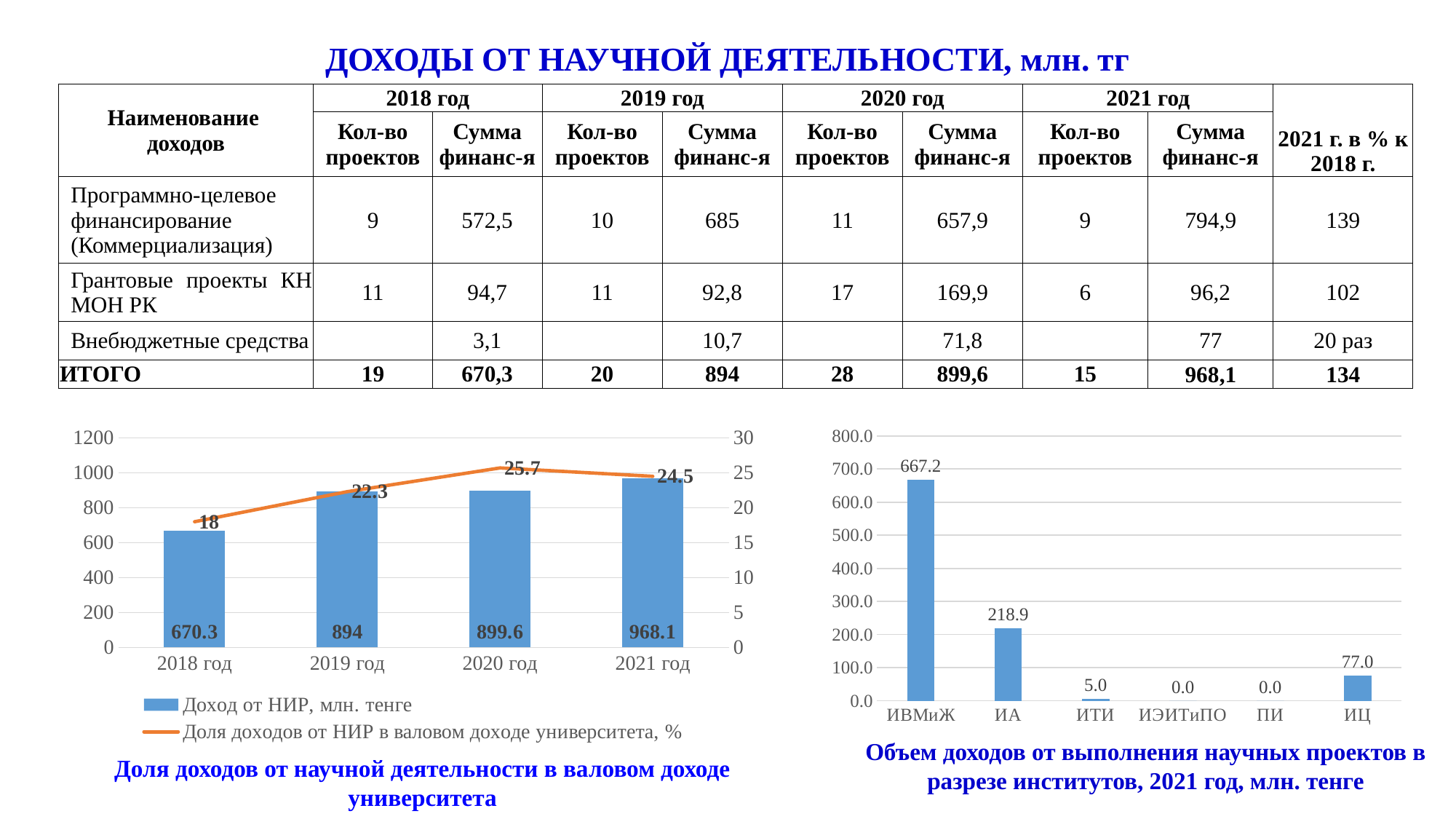
In the right chart, what is the difference between the values for ИВМиЖ and ИЦ? 590.2 In the left chart, what is the value of 'Доход от НИР, млн. тенге' for 2021 год? 968.1 In the right chart, what is the value for ИА? 218.9 In the left chart, does the 'Доход от НИР, млн. тенге' series rise or fall from 2018 год to 2021 год? rise In the left chart, what is the difference between the 'Доход от НИР' values for 2021 год and 2018 год? 297.8 In the left chart, which year has the highest share of research income in the university's gross income (the line series)? 2020 год In the left chart, what is the value of 'Доля доходов от НИР в валовом доходе университета, %' for 2020 год? 25.7 In the left chart, how many series does the legend list? 2 In the right chart, which institute has the highest value? ИВМиЖ In the right chart, how many institutes are shown on the x axis? 6 In the left chart, which year has the lowest value of 'Доход от НИР, млн. тенге'? 2018 год What kind of chart is the right chart? bar chart